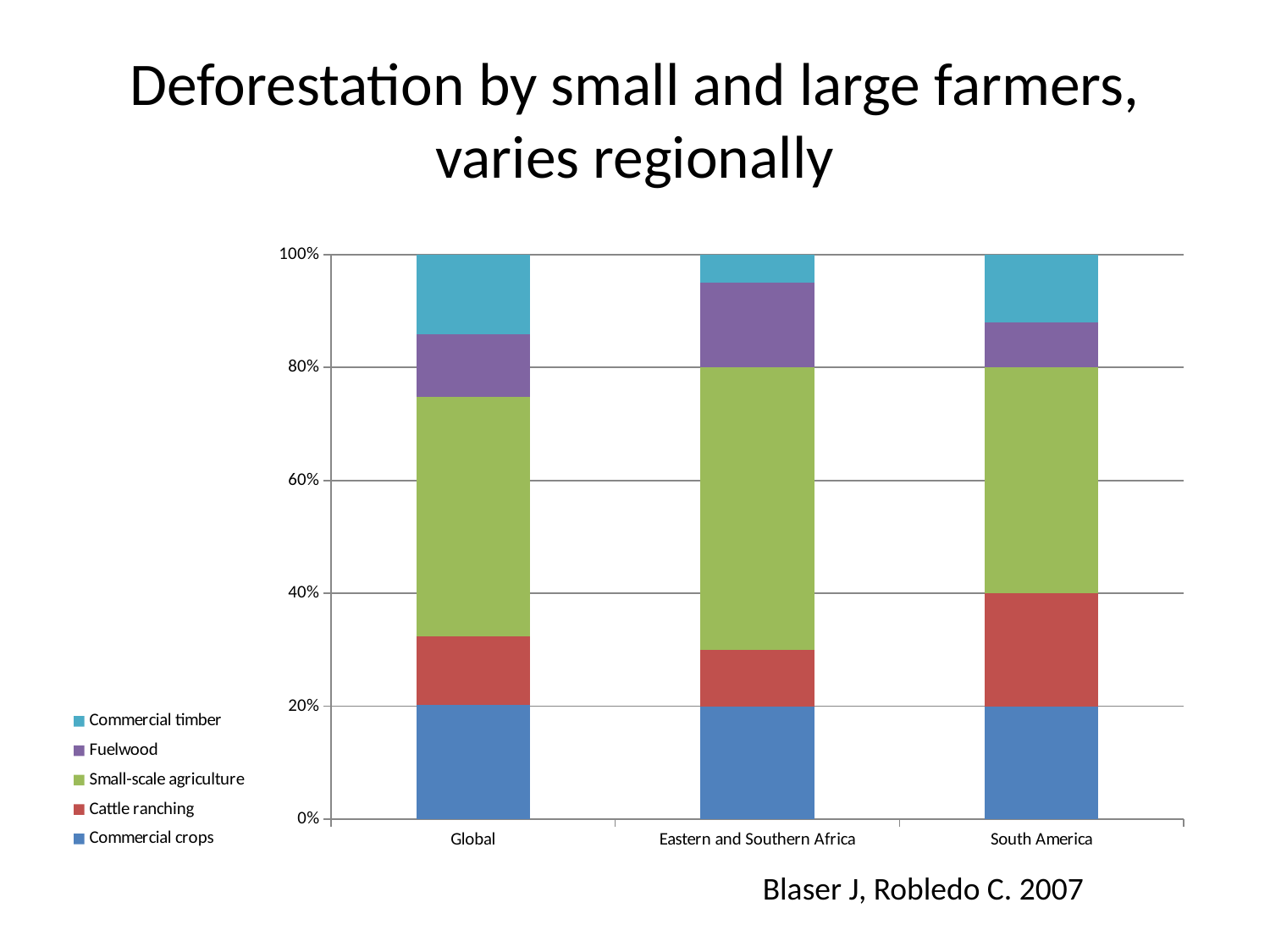
Is the Commercial timber segment larger for Global or for Eastern and Southern Africa? Global Which region has the largest Small-scale agriculture segment? Eastern and Southern Africa Which series takes the largest share of the Global bar? Small-scale agriculture What colour represents Fuelwood in the legend? Purple What is the value for Cattle ranching in the South America bar? 20% Is the Small-scale agriculture value for Eastern and Southern Africa greater or less than 40%? greater Which region has the largest Cattle ranching segment? South America What is the total height of each stacked bar? 100% What kind of chart is shown on the slide? Stacked bar chart How many series does the legend list? 5 How many regions/categories are shown on the x axis? 3